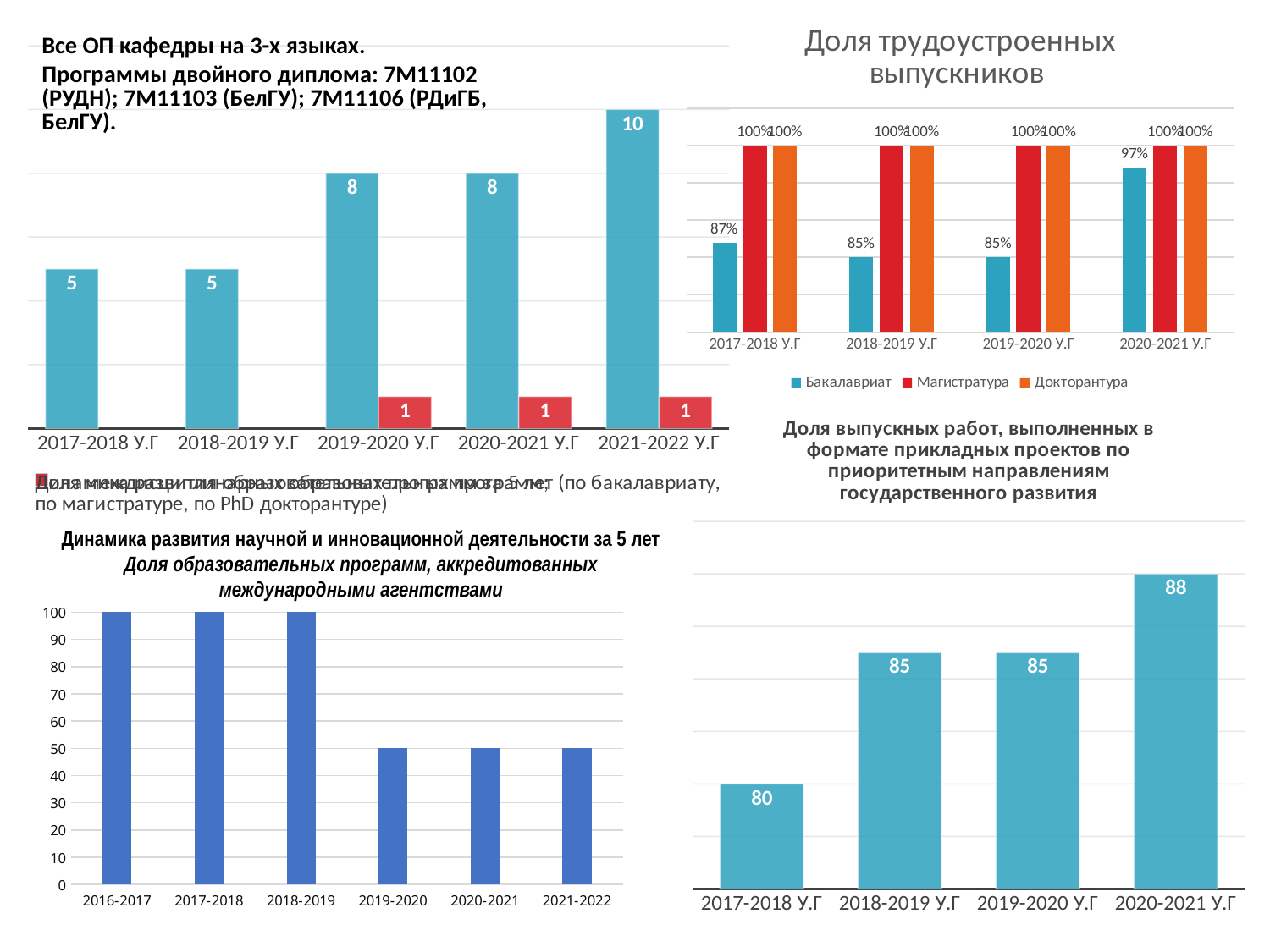
In the bottom-right chart 'Доля выпускных работ, выполненных в формате прикладных проектов...', what is the value for 2017-2018 У.Г? 80 In the bottom-right chart 'Доля выпускных работ, выполненных в формате прикладных проектов...', what is the difference between the values for 2020-2021 У.Г and 2017-2018 У.Г? 8 In the chart 'Доля трудоустроенных выпускников', what is the value for Бакалавриат in 2020-2021 У.Г? 97% In the chart 'Доля образовательных программ, аккредитованных международными агентствами', what is the value for 2019-2020? 50 In the top-left chart, which year has the highest blue bar? 2021-2022 У.Г In the chart 'Доля трудоустроенных выпускников', what is the value for Бакалавриат in 2017-2018 У.Г? 87% In the top-left chart, what is the difference between the blue bar values for 2021-2022 У.Г and 2017-2018 У.Г? 5 In the top-left chart, what is the value of the blue bar for 2021-2022 У.Г? 10 In the chart 'Доля трудоустроенных выпускников', which year has the lowest value for Бакалавриат? 2018-2019 У.Г and 2019-2020 У.Г (85%) In the top-left chart, what is the value of the red bar for 2019-2020 У.Г? 1 How many series does the legend of the chart 'Доля трудоустроенных выпускников' list? 3 How many categories are shown on the x axis of the chart 'Доля образовательных программ, аккредитованных международными агентствами'? 6